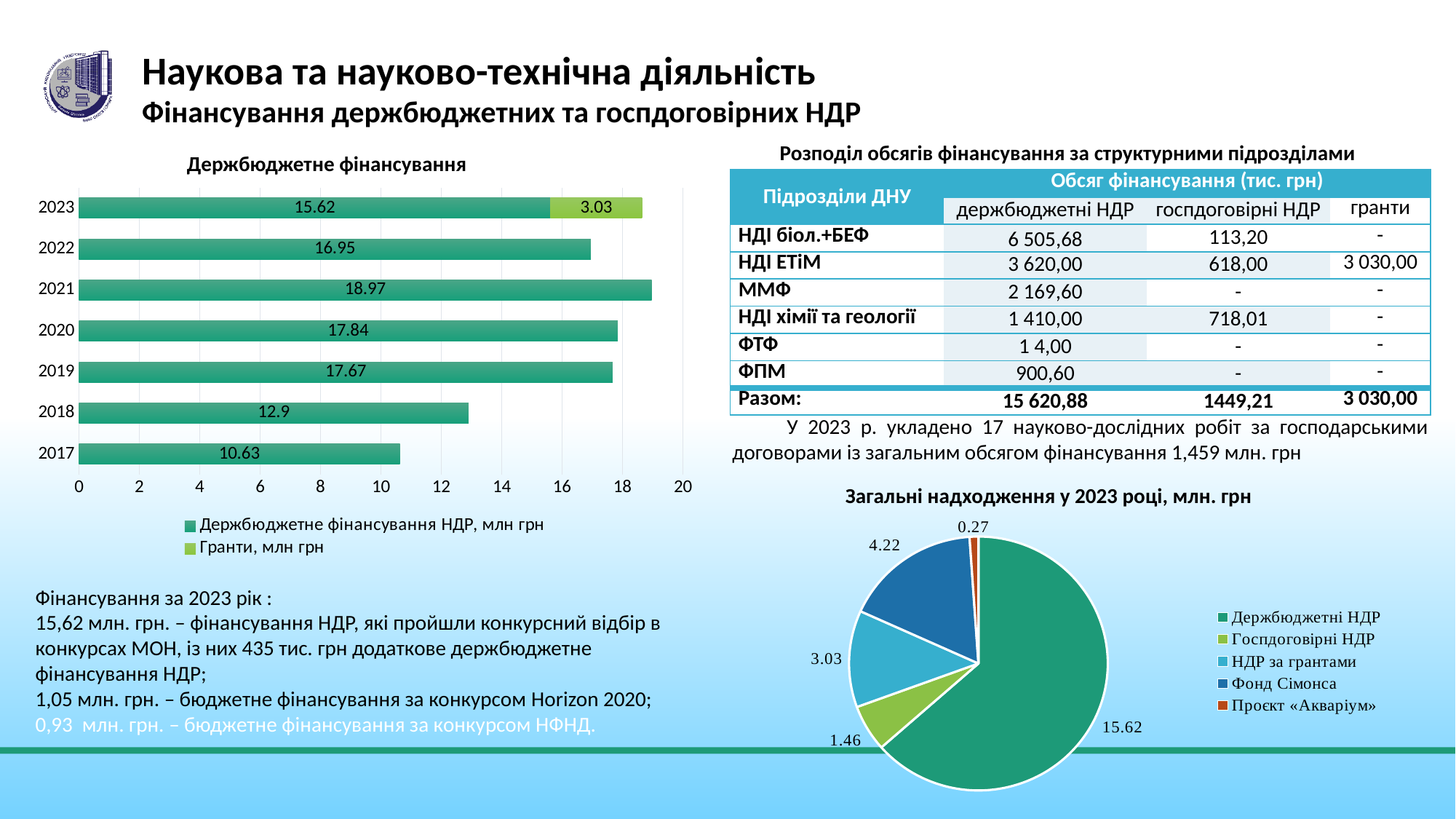
What type of chart is 'Держбюджетне фінансування'? Bar chart In the bar chart 'Держбюджетне фінансування', how many series does the legend list? 2 In the bar chart 'Держбюджетне фінансування', what is the total of the stacked bar for 2023 (state budget funding plus grants)? 18.65 In the pie chart 'Загальні надходження у 2023 році, млн. грн', which category has the smallest slice? Проєкт «Акваріум» In the pie chart 'Загальні надходження у 2023 році, млн. грн', how many slices are there? 5 In the bar chart 'Держбюджетне фінансування', which year has the larger state budget funding, 2020 or 2019? 2020 In the pie chart 'Загальні надходження у 2023 році, млн. грн', what is the value for Фонд Сімонса? 4.22 In the bar chart 'Держбюджетне фінансування', how many years are shown? 7 In the bar chart 'Держбюджетне фінансування', which year has the lowest state budget funding? 2017 In the bar chart 'Держбюджетне фінансування', which year has the highest state budget funding (Держбюджетне фінансування НДР)? 2021 In the bar chart 'Держбюджетне фінансування', what is the value of state budget funding (Держбюджетне фінансування НДР) for 2021? 18.97 In the bar chart 'Держбюджетне фінансування', what is the difference between the state budget funding in 2022 and in 2018? 4.05